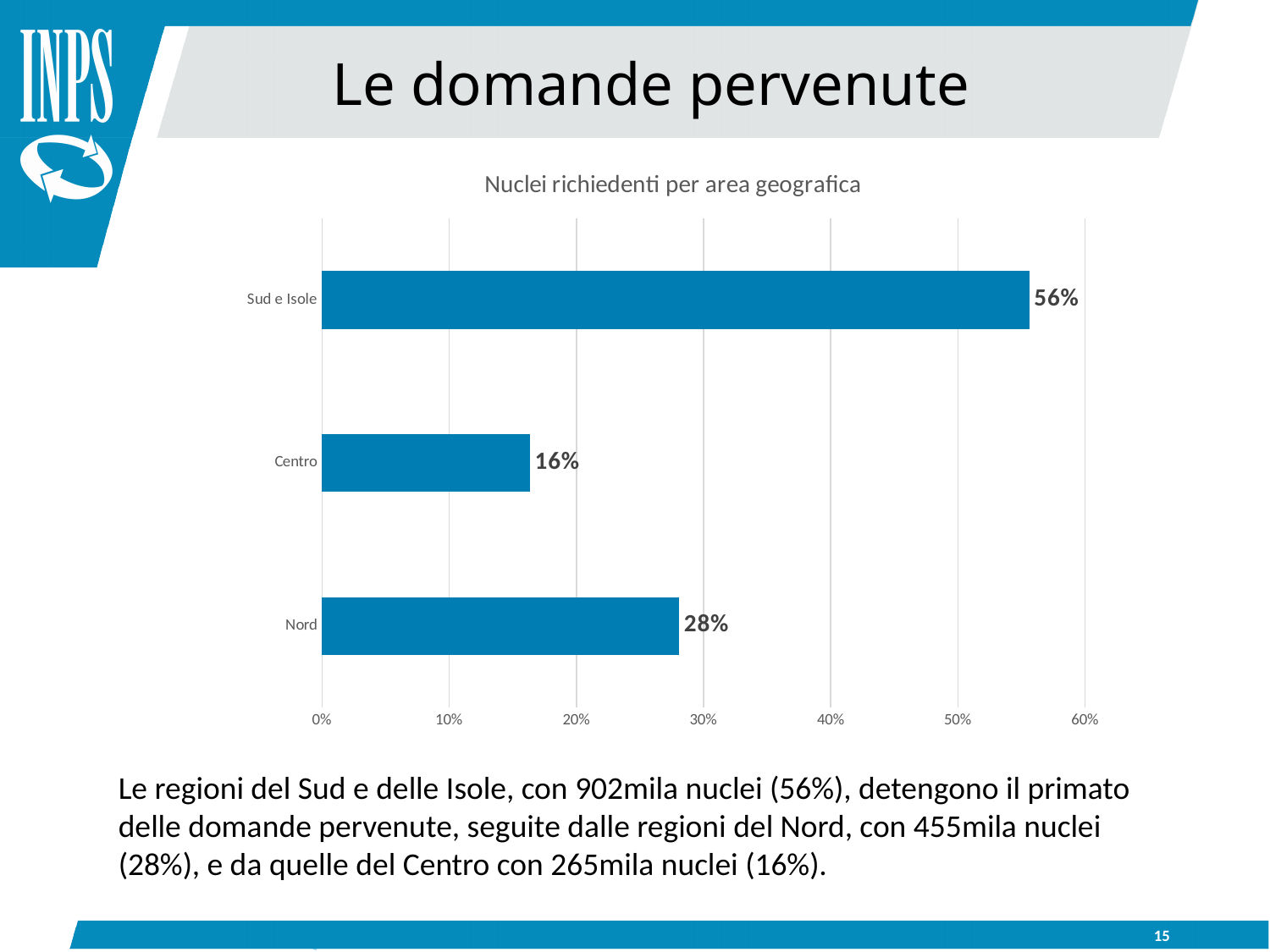
Is the value for Sud e Isole greater or less than 50%? greater What is the title of the chart? Nuclei richiedenti per area geografica What is the value for Sud e Isole? 56% Which area has the lowest value? Centro What is the difference between the values for Sud e Isole and Nord? 28% What kind of chart is shown? bar chart What is the difference between the values for Nord and Centro? 12% Which is larger, the value for Nord or the value for Centro? Nord What is the value for Nord? 28% Which area has the highest value? Sud e Isole How many areas are shown in the chart? 3 What is the value for Centro? 16%